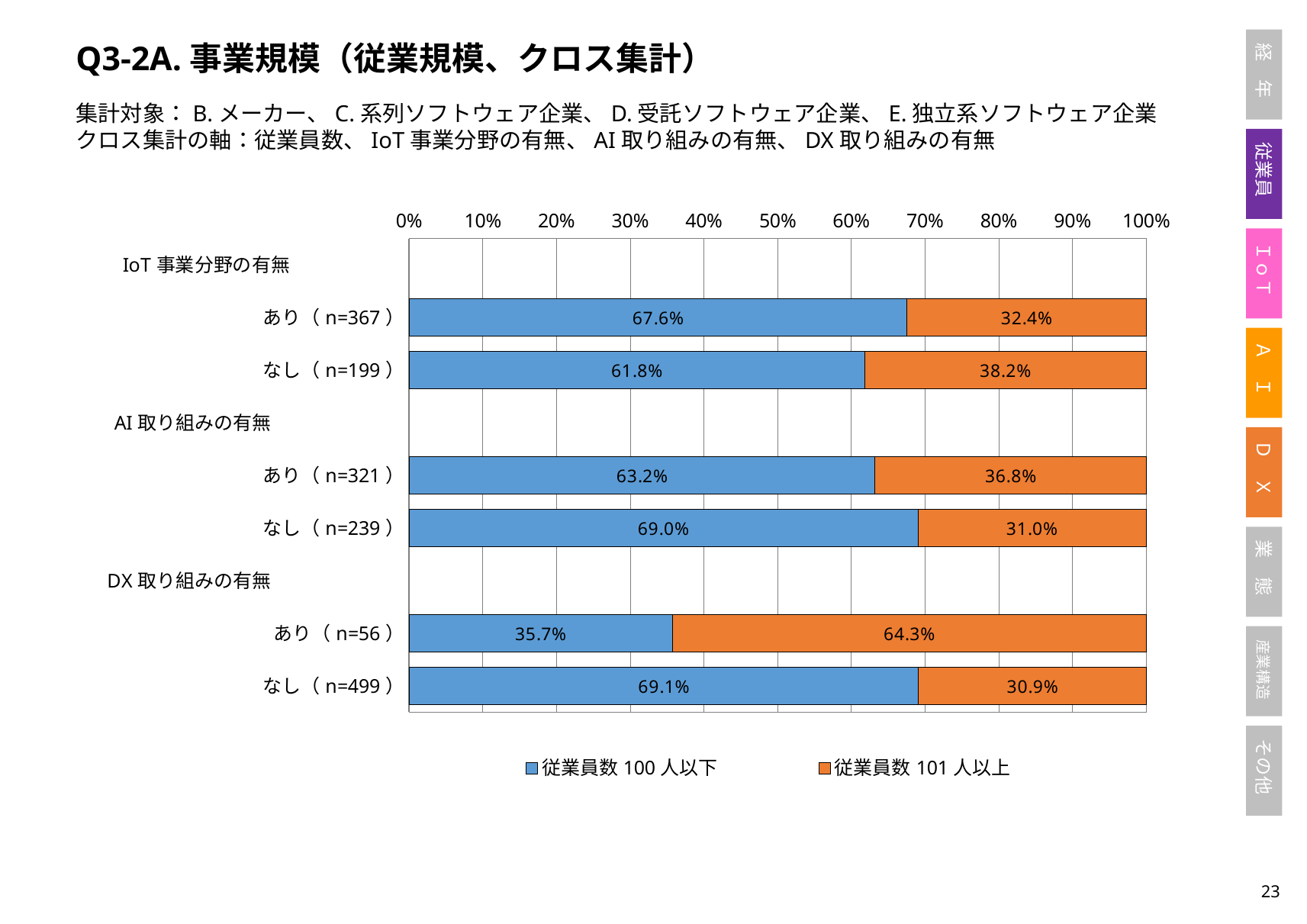
Which row has the highest value for 従業員数 100 人以下? DX 取り組みの有無 なし (n=499) How many series does the legend list? 2 What is the value of 従業員数 100 人以下 for IoT 事業分野の有無 あり (n=367)? 67.6% What is the difference between the 従業員数 100 人以下 values for AI 取り組みの有無 なし (n=239) and AI 取り組みの有無 あり (n=321)? 5.8% Which is larger: the 従業員数 101 人以上 value for IoT 事業分野の有無 あり (n=367) or for IoT 事業分野の有無 なし (n=199)? IoT 事業分野の有無 なし (n=199) What type of chart is shown on the slide? Stacked bar chart What is the value of 従業員数 101 人以上 for DX 取り組みの有無 あり (n=56)? 64.3% What is the value of 従業員数 100 人以下 for AI 取り組みの有無 あり (n=321)? 63.2% What colour represents 従業員数 101 人以上 in the chart? Orange What is the value of 従業員数 101 人以上 for IoT 事業分野の有無 なし (n=199)? 38.2% How many data rows (bars) are plotted in the chart? 6 Which row has the lowest value for 従業員数 100 人以下? DX 取り組みの有無 あり (n=56)